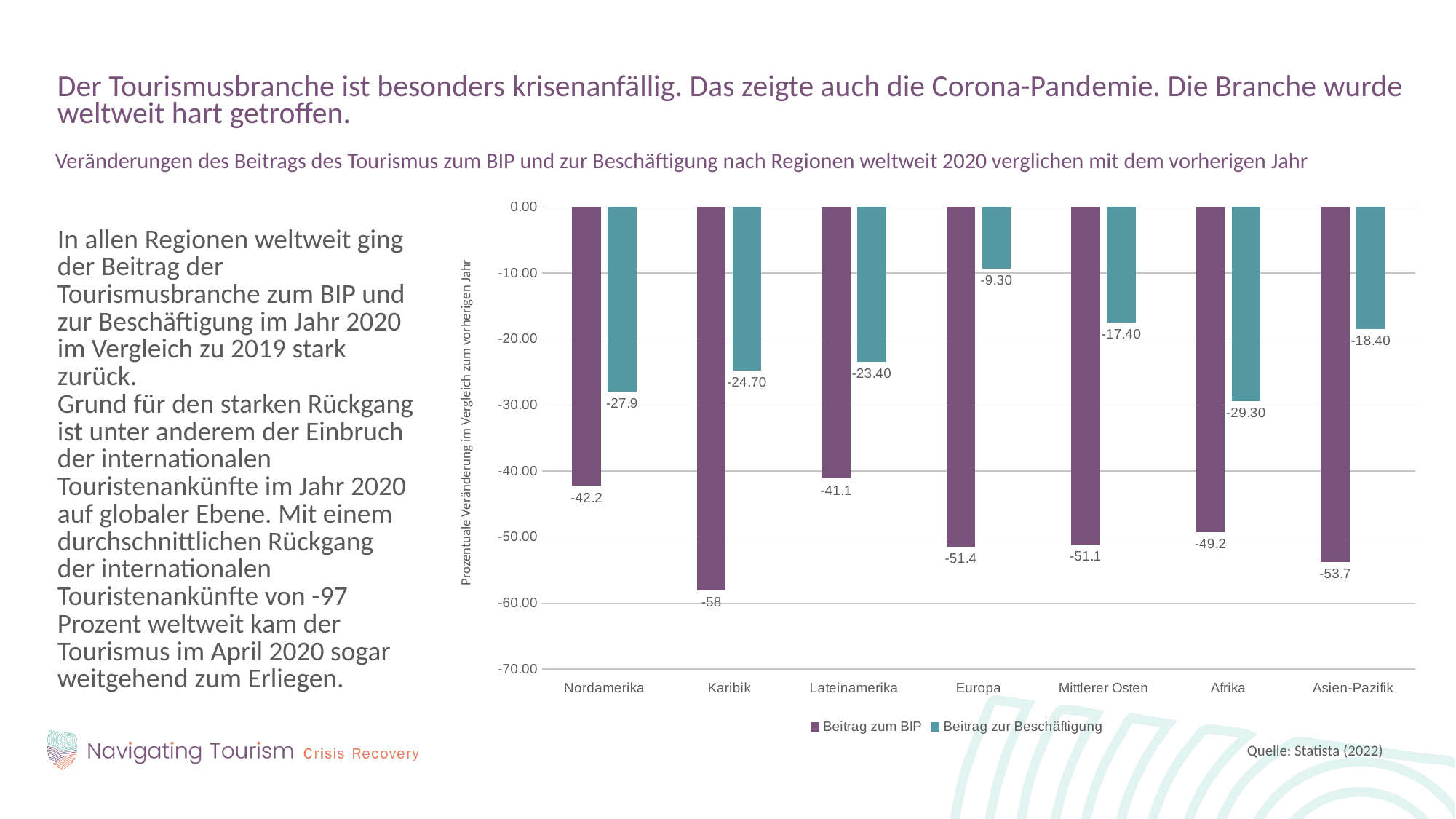
What is the value for Beitrag zum BIP for Asien-Pazifik? -53.7 What kind of chart is shown on the slide? Bar chart Which region has the least negative value for Beitrag zur Beschäftigung? Europa What is the value for Beitrag zur Beschäftigung for Mittlerer Osten? -17.40 What is the value for Beitrag zur Beschäftigung for Europa? -9.30 Which is more negative for Nordamerika: Beitrag zum BIP or Beitrag zur Beschäftigung? Beitrag zum BIP What is the difference between the Beitrag zum BIP and Beitrag zur Beschäftigung values for Europa? 42.1 What is the value for Beitrag zum BIP for Karibik? -58 How many series does the chart legend list? 2 Which region has the most negative value for Beitrag zum BIP? Karibik Which region has the most negative value for Beitrag zur Beschäftigung? Afrika How many regions are shown on the x axis of the chart? 7